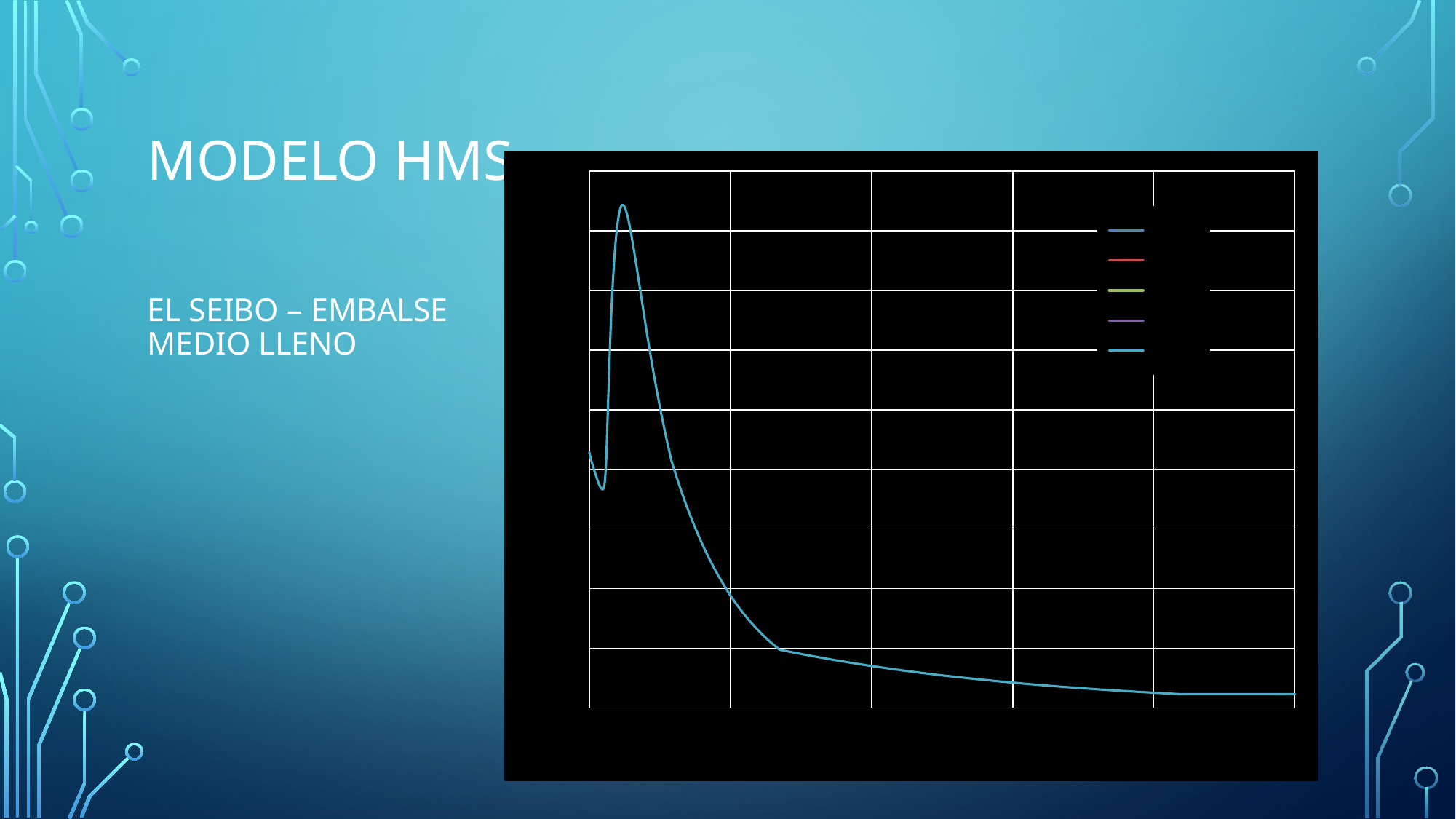
After reaching its peak near the left of the chart, does the plotted line rise or fall as it moves to the right? fall Where along the x axis does the plotted line reach its highest point: near the left or near the right of the chart? near the left What kind of chart is shown on the slide? line chart How many lines are actually plotted on the chart? 1 What colour is the plotted line on the chart? light blue How many entries (colour swatches) does the chart's legend list? 5 What is the background colour of the chart area? black